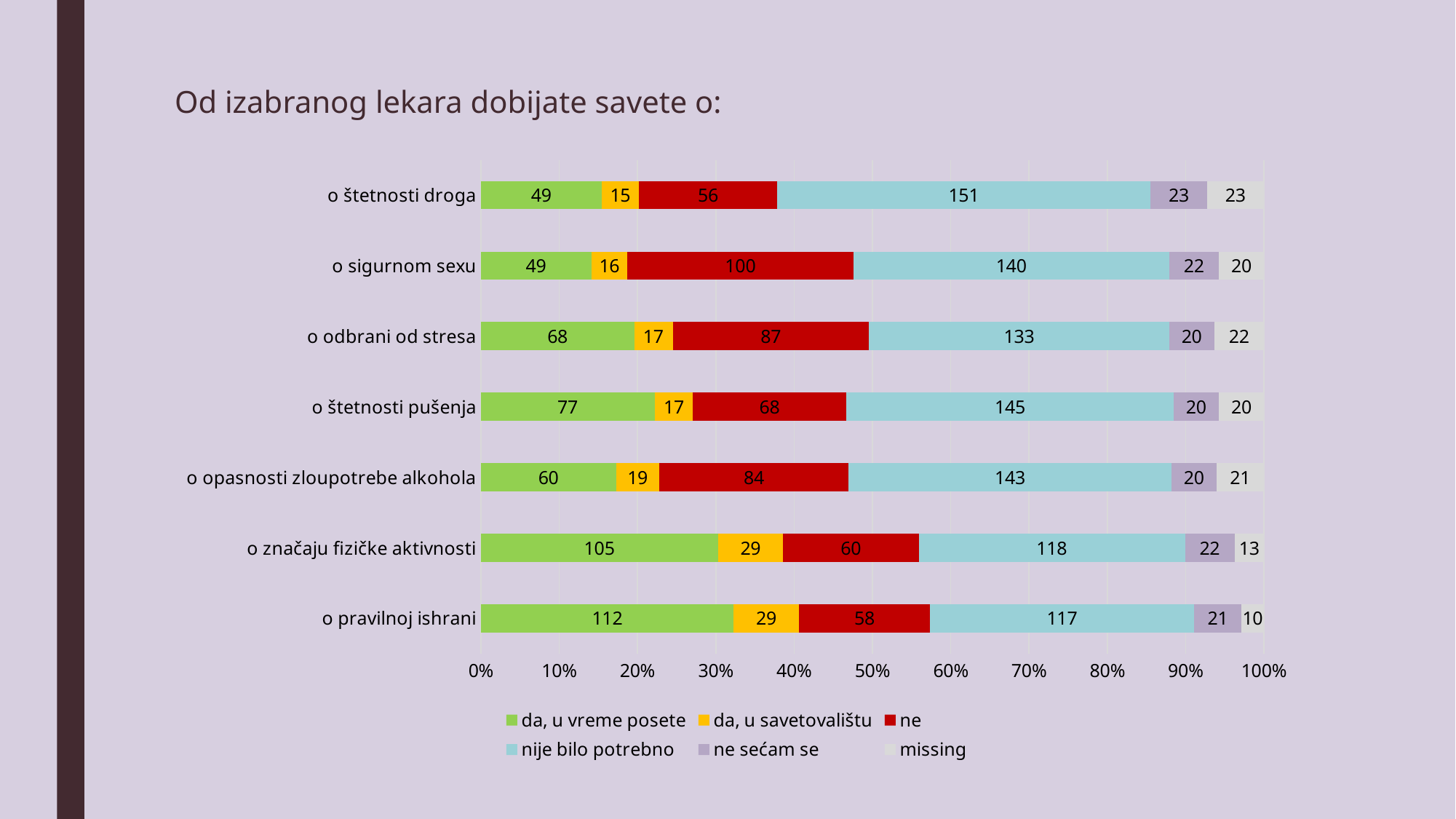
What is the title of the slide? Od izabranog lekara dobijate savete o: What is the difference between the "nije bilo potrebno" values for "o štetnosti droga" and "o pravilnoj ishrani"? 34 What kind of chart is shown on the slide? Stacked bar chart What is the value of "ne sećam se" for "o štetnosti droga"? 23 How many categories are shown on the chart? 7 What is the value of "da, u vreme posete" for "o pravilnoj ishrani"? 112 What is the value of "ne" for "o sigurnom sexu"? 100 Which category has the highest value for "da, u vreme posete"? o pravilnoj ishrani Which has the larger "ne" value: "o odbrani od stresa" or "o opasnosti zloupotrebe alkohola"? o odbrani od stresa How many series does the legend list? 6 Which category has the lowest value for "missing"? o pravilnoj ishrani What is the total of all segments in the bar for "o značaju fizičke aktivnosti"? 347